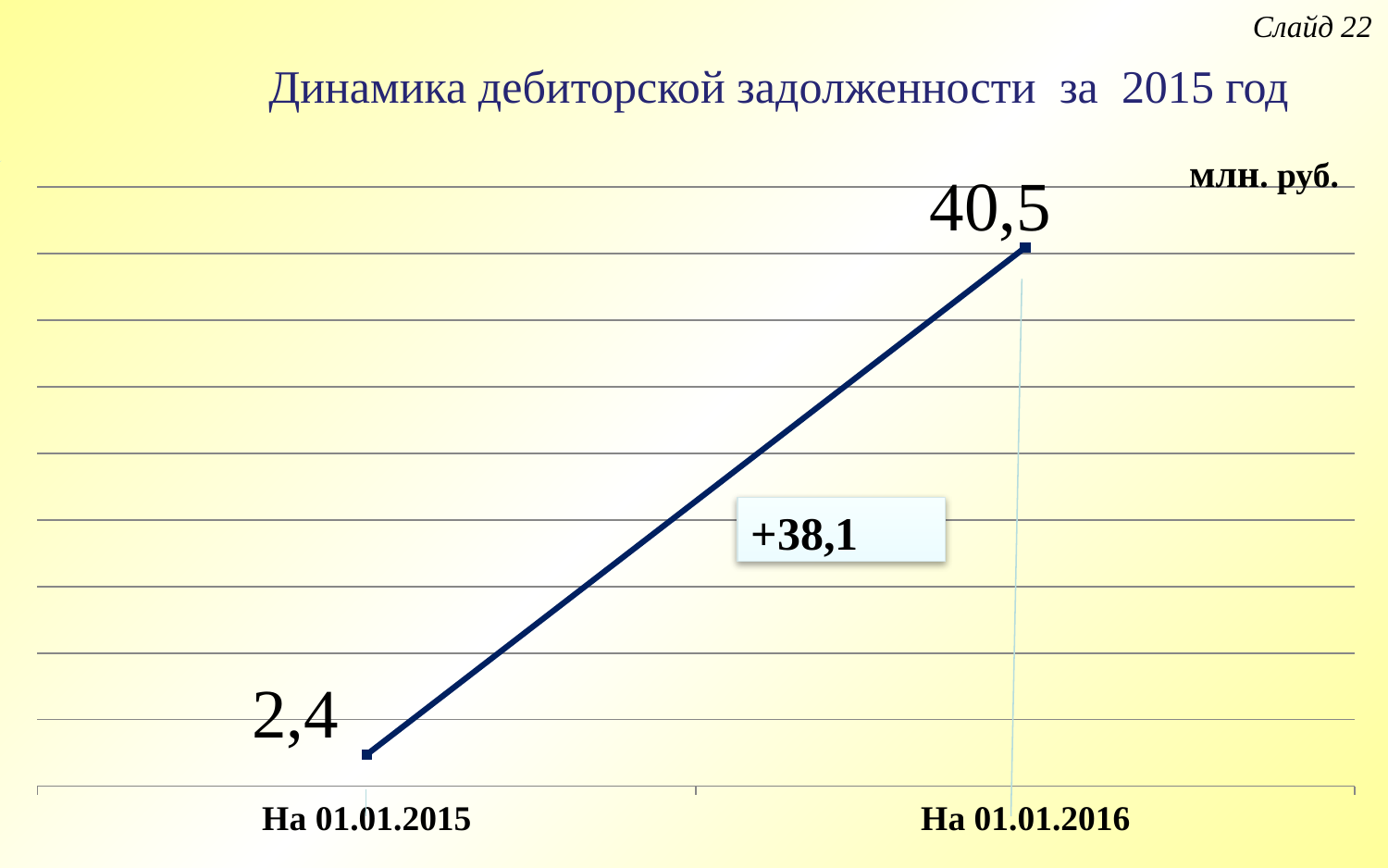
What unit is indicated for the values on the chart? млн. руб. Is the value for На 01.01.2016 larger than the value for На 01.01.2015? Yes What is the title of the chart? Динамика дебиторской задолженности за 2015 год What change is shown in the label box on the line? +38,1 Which date has the higher value? На 01.01.2016 What is the difference between the values for На 01.01.2016 and На 01.01.2015? 38,1 What kind of chart is shown on the slide? Line chart Do the values rise or fall from На 01.01.2015 to На 01.01.2016? Rise Which date has the lower value? На 01.01.2015 What is the value for На 01.01.2015? 2,4 What is the value for На 01.01.2016? 40,5 How many data points are plotted on the chart? 2